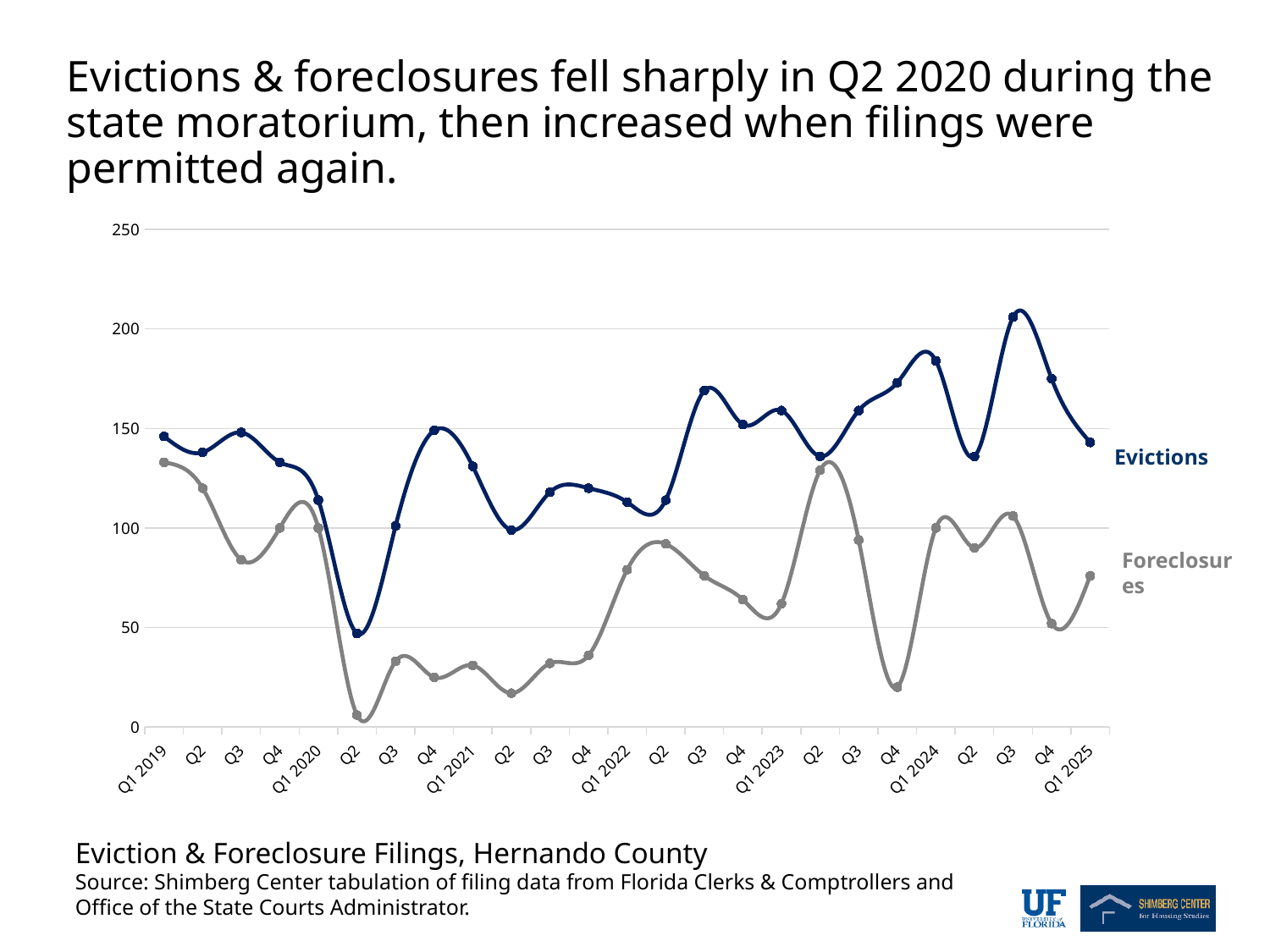
How many quarterly data points does each line have, from Q1 2019 to Q1 2025? 25 In Q2 2020, which series has the larger value, Evictions or Foreclosures? Evictions What kind of chart is shown on the slide? line chart In which quarter does the Foreclosures line reach its lowest value? Q2 2020 What is the title of the chart given below the plot? Eviction & Foreclosure Filings, Hernando County How many series are plotted on the chart? 2 Is the Foreclosures value for Q4 2023 greater or less than 50? less Do Evictions rise or fall from Q1 2020 to Q2 2020? fall In which quarter does the Evictions line reach its lowest value? Q2 2020 In which quarter does the Evictions line reach its highest value? Q3 2024 Is the Evictions value for Q3 2024 greater or less than 200? greater Is the Foreclosures value for Q2 2023 greater or less than 100? greater